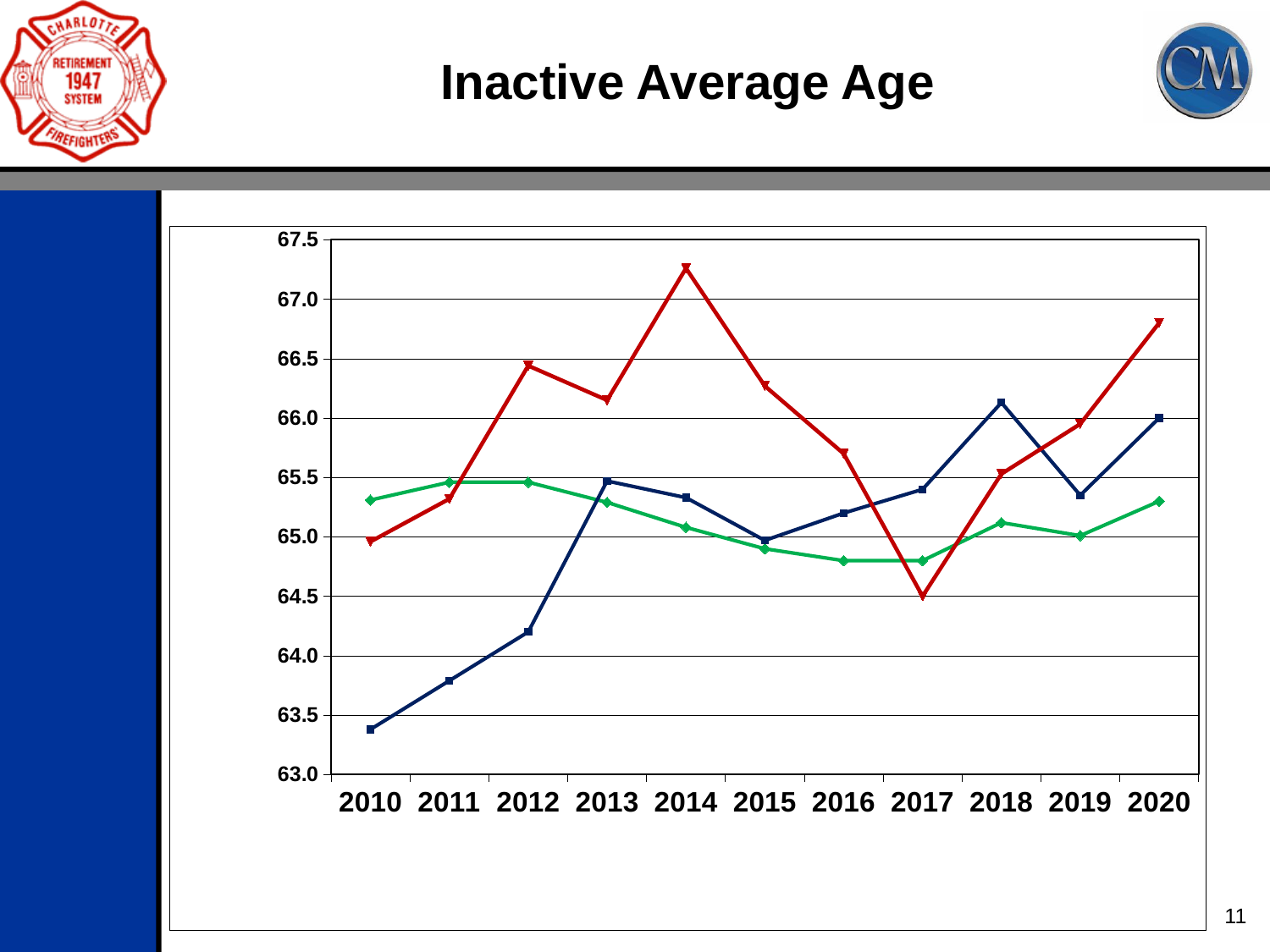
In which year does the red line reach its highest value? 2014 In which year does the dark blue line have its lowest value? 2010 Is the value of the red line in 2014 greater or less than 67.0? greater In which year does the red line reach its lowest value? 2017 How many lines are plotted on the chart? 3 Does the dark blue line rise or fall from 2010 to 2013? rise Is the value of the dark blue line in 2010 greater or less than 63.5? less What kind of chart is shown on the slide? line chart In 2010, which line has the higher value, the green line or the dark blue line? green line Is the value of the green line in 2016 greater or less than 65.0? less How many years are plotted along the x axis of the chart? 11 What is the title of the slide's chart? Inactive Average Age